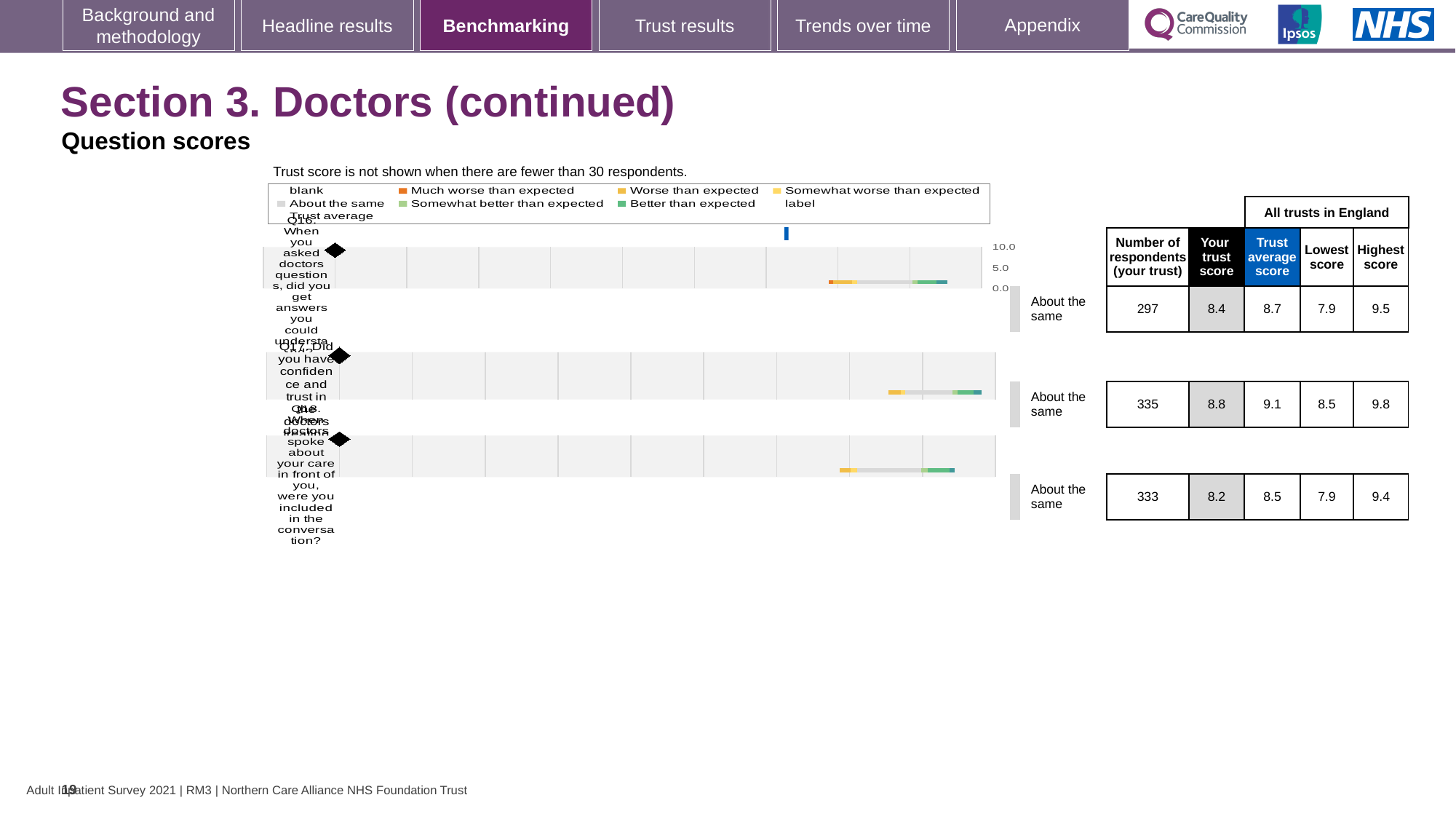
How many questions are plotted in the chart? 3 What kind of chart is shown on the slide? bar chart What is the lowest score across all trusts in England for Q17? 8.5 For Q17, what is the difference between the trust average score and your trust score? 0.3 Which question has the highest 'Your trust score'? Q17 How many respondents from the trust answered Q16? 297 What is the 'Your trust score' for Q17 (Did you have confidence and trust in the doctors treating you)? 8.8 What is the highest score across all trusts in England for Q18? 9.4 Is the trust score for Q16 greater or less than 5.0 on the chart axis? greater Which question has the lowest 'Your trust score'? Q18 What benchmark category is shown for Q17? About the same For Q16, which is larger: your trust score or the trust average score? Trust average score